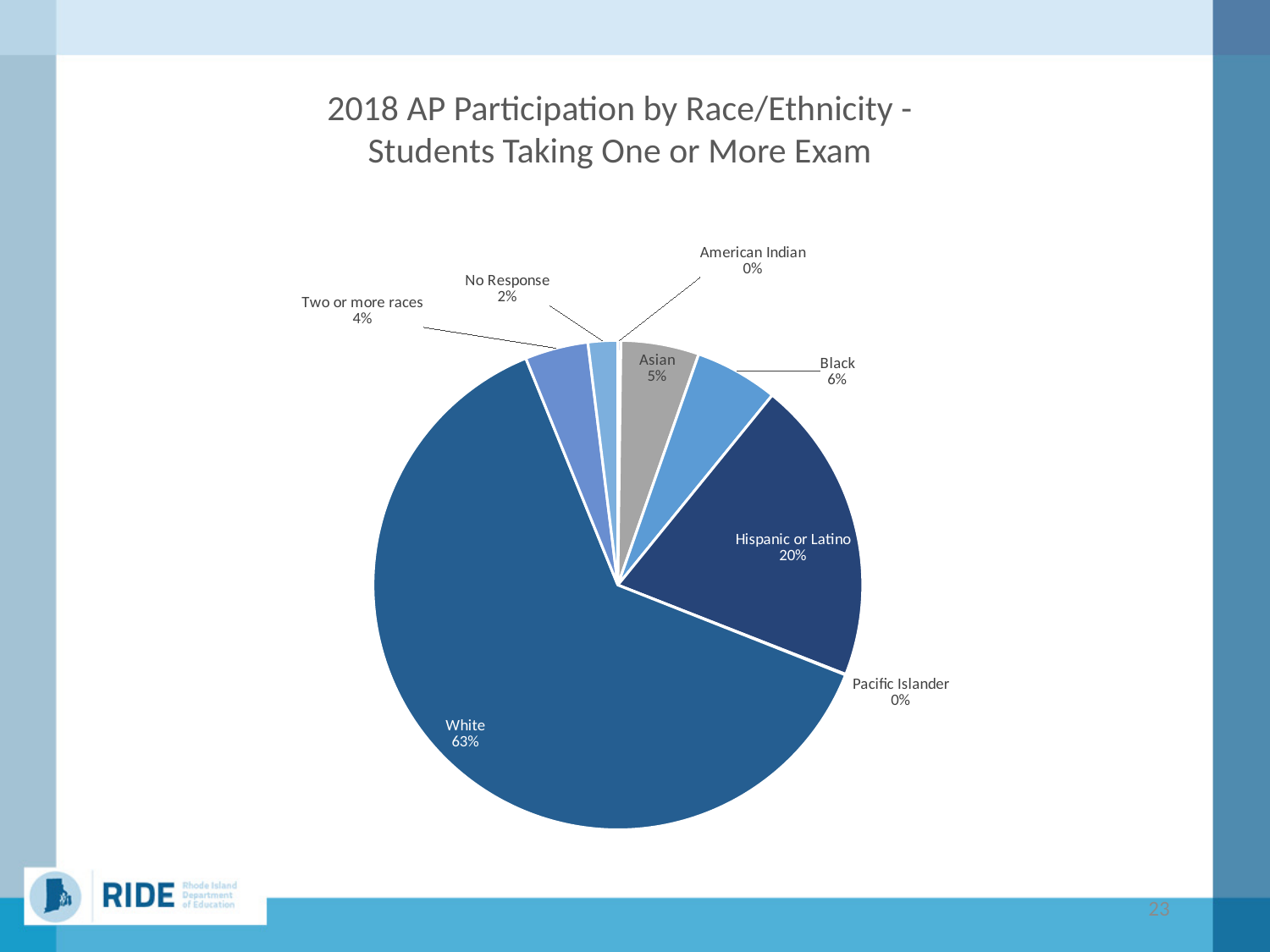
What is the value shown for Two or more races? 4% What is the title of the chart? 2018 AP Participation by Race/Ethnicity - Students Taking One or More Exam How many categories are labelled on the pie chart? 8 What is the difference between the White share and the Hispanic or Latino share? 43% What is the value shown for Asian? 5% What share of the pie does Hispanic or Latino represent? 20% What share of the pie does White represent? 63% Which is larger, the slice for Black or the slice for Asian? Black Which category has the largest slice of the pie? White What is the value shown for Black? 6% What is the value shown for No Response? 2% What kind of chart is shown on the slide? pie chart